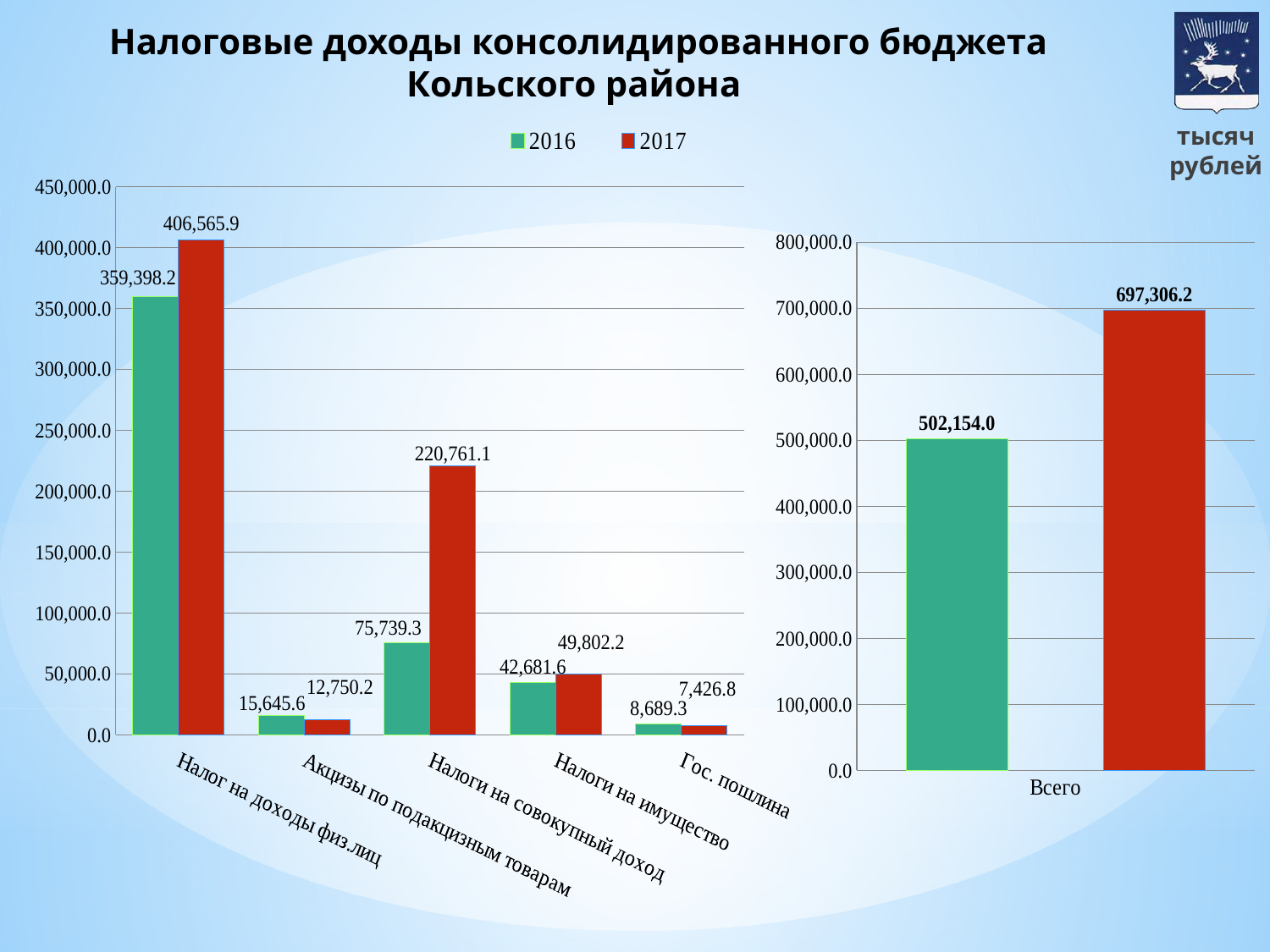
On the left chart, which category has the highest 2017 value? Налог на доходы физ.лиц On the left chart, what is the 2016 value for Налоги на совокупный доход? 75,739.3 On the left chart, what is the 2017 value for Гос. пошлина? 7,426.8 What kind of chart is the right chart (Всего)? Bar chart On the left chart, which is larger for Акцизы по подакцизным товарам: the 2016 value or the 2017 value? 2016 How many series does the legend list? 2 On the right chart (Всего), what is the difference between the 2017 and 2016 values? 195,152.2 How many categories are shown on the left chart? 5 On the left chart, what is the 2017 value for Налог на доходы физ.лиц? 406,565.9 On the right chart (Всего), what is the value for 2017? 697,306.2 On the left chart, what is the difference between the 2017 and 2016 values for Налоги на совокупный доход? 145,021.8 On the left chart, which category has the lowest 2016 value? Гос. пошлина